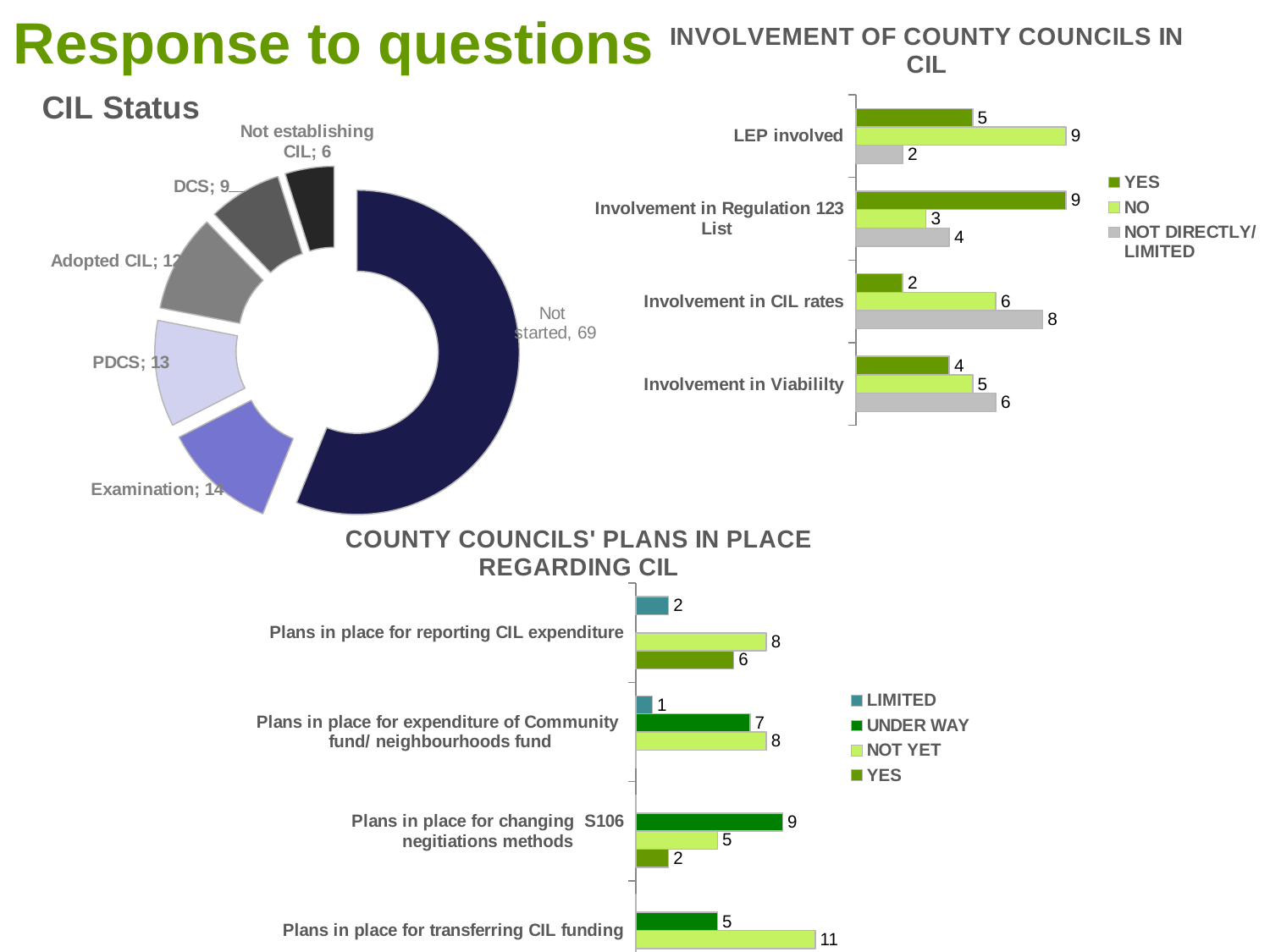
In the County Councils' Plans in Place Regarding CIL chart, which is larger for Plans in place for changing S106 negitiations methods: UNDER WAY or NOT YET? UNDER WAY In the Involvement of County Councils in CIL chart, which category has the highest YES value? Involvement in Regulation 123 List In the CIL Status chart, what is the difference between Examination and DCS? 5 How many series does the legend of the Involvement of County Councils in CIL chart list? 3 In the County Councils' Plans in Place Regarding CIL chart, what is the NOT YET value for Plans in place for transferring CIL funding? 11 In the CIL Status chart, which category has the smallest value? Not establishing CIL In the Involvement of County Councils in CIL chart, what is the NO value for LEP involved? 9 In the Involvement of County Councils in CIL chart, what is the NOT DIRECTLY/LIMITED value for Involvement in CIL rates? 8 In the CIL Status chart, what is the value for Not started? 69 How many categories are shown in the County Councils' Plans in Place Regarding CIL chart? 4 What kind of chart is the CIL Status chart? Doughnut chart How many series does the legend of the County Councils' Plans in Place Regarding CIL chart list? 4